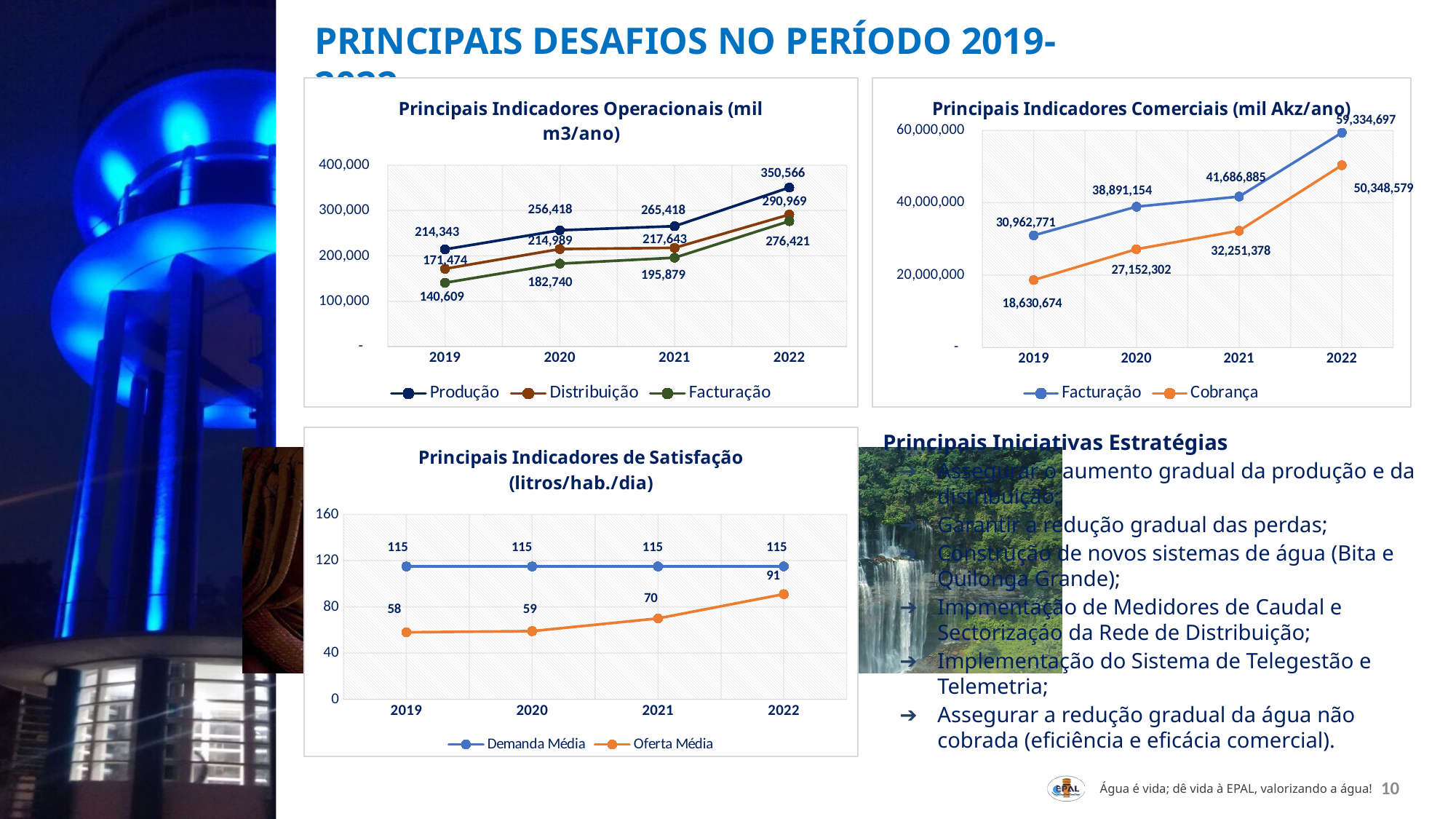
In the 'Principais Indicadores Comerciais' chart, does Cobrança rise or fall from 2019 to 2022? rise In the 'Principais Indicadores Operacionais' chart, what is the value of Facturação in 2019? 140,609 In the 'Principais Indicadores Operacionais' chart, what is the difference between Produção and Distribuição in 2021? 47,775 In the 'Principais Indicadores Operacionais' chart, what is the value of Produção in 2022? 350,566 In the 'Principais Indicadores Comerciais' chart, in which year is Facturação highest? 2022 In the 'Principais Indicadores Comerciais' chart, what is the value of Cobrança in 2020? 27,152,302 In the 'Principais Indicadores de Satisfação' chart, what is the value of Oferta Média in 2021? 70 What type of chart is the 'Principais Indicadores de Satisfação' chart? line chart In the 'Principais Indicadores Comerciais' chart, is the value of Cobrança in 2019 greater or less than 20,000,000? less In the 'Principais Indicadores de Satisfação' chart, in which year is Oferta Média lowest? 2019 In the 'Principais Indicadores Operacionais' chart, how many series does the legend list? 3 In the 'Principais Indicadores de Satisfação' chart, what is the difference between Demanda Média and Oferta Média in 2022? 24